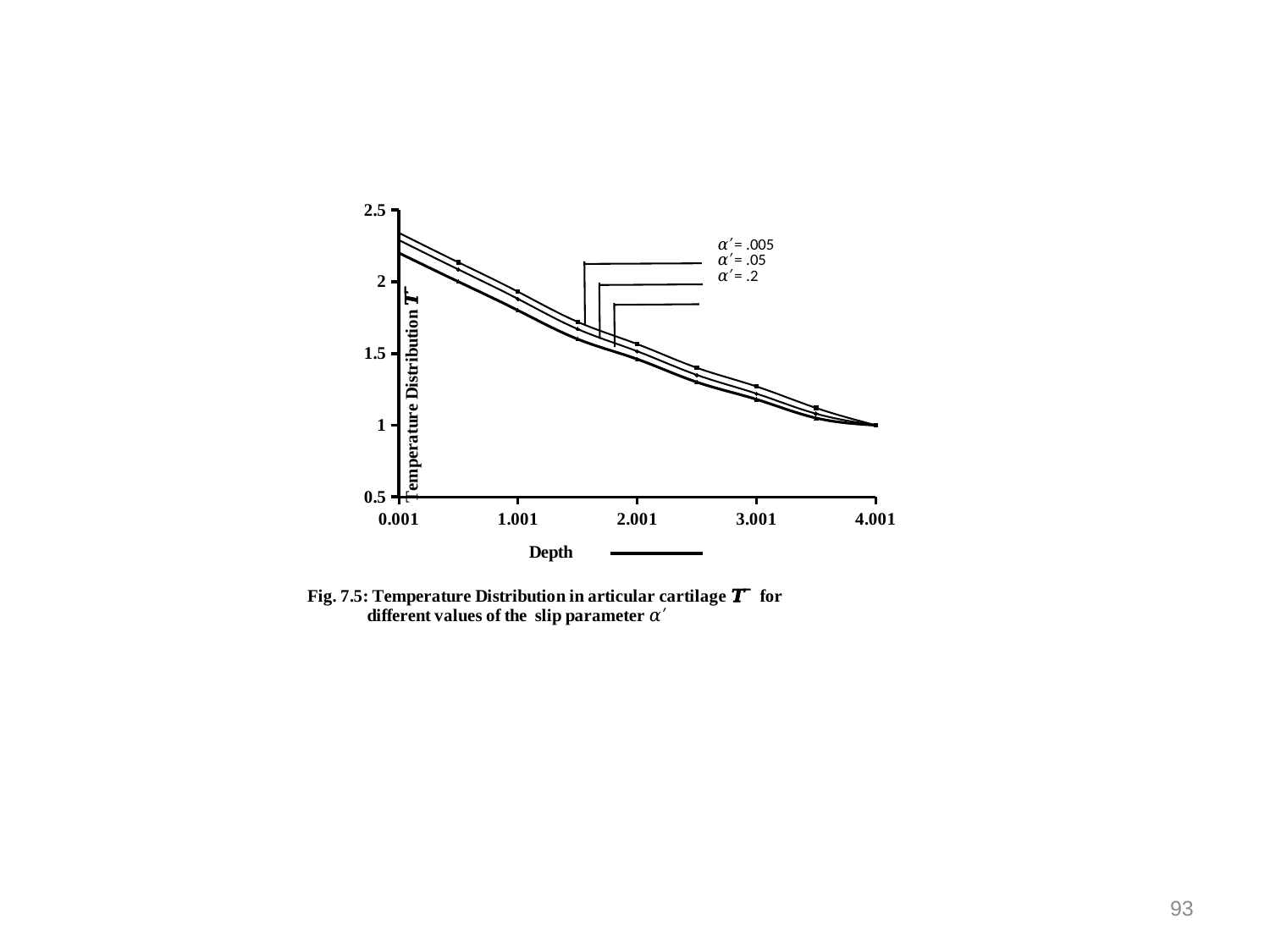
What is the title of the x axis? Depth What kind of chart is shown on the slide? line chart Is the value for α′ = .005 at depth 1.001 greater or less than 1.5? greater How many tick labels are shown on the x axis? 5 Which series has the lowest temperature distribution at depth 0.001? α′ = .2 At depth 2.001, which series has the larger value, α′ = .005 or α′ = .2? α′ = .005 Which series has the highest temperature distribution at depth 1.001? α′ = .005 Is the value for α′ = .005 at depth 0.001 greater or less than 2? greater How many series (values of the slip parameter α′) are plotted on the chart? 3 Is the value for α′ = .2 at depth 3.001 greater or less than 1.5? less What value do all three series reach at depth 4.001? 1 Do the temperature distribution values rise or fall as depth increases along the x axis? fall